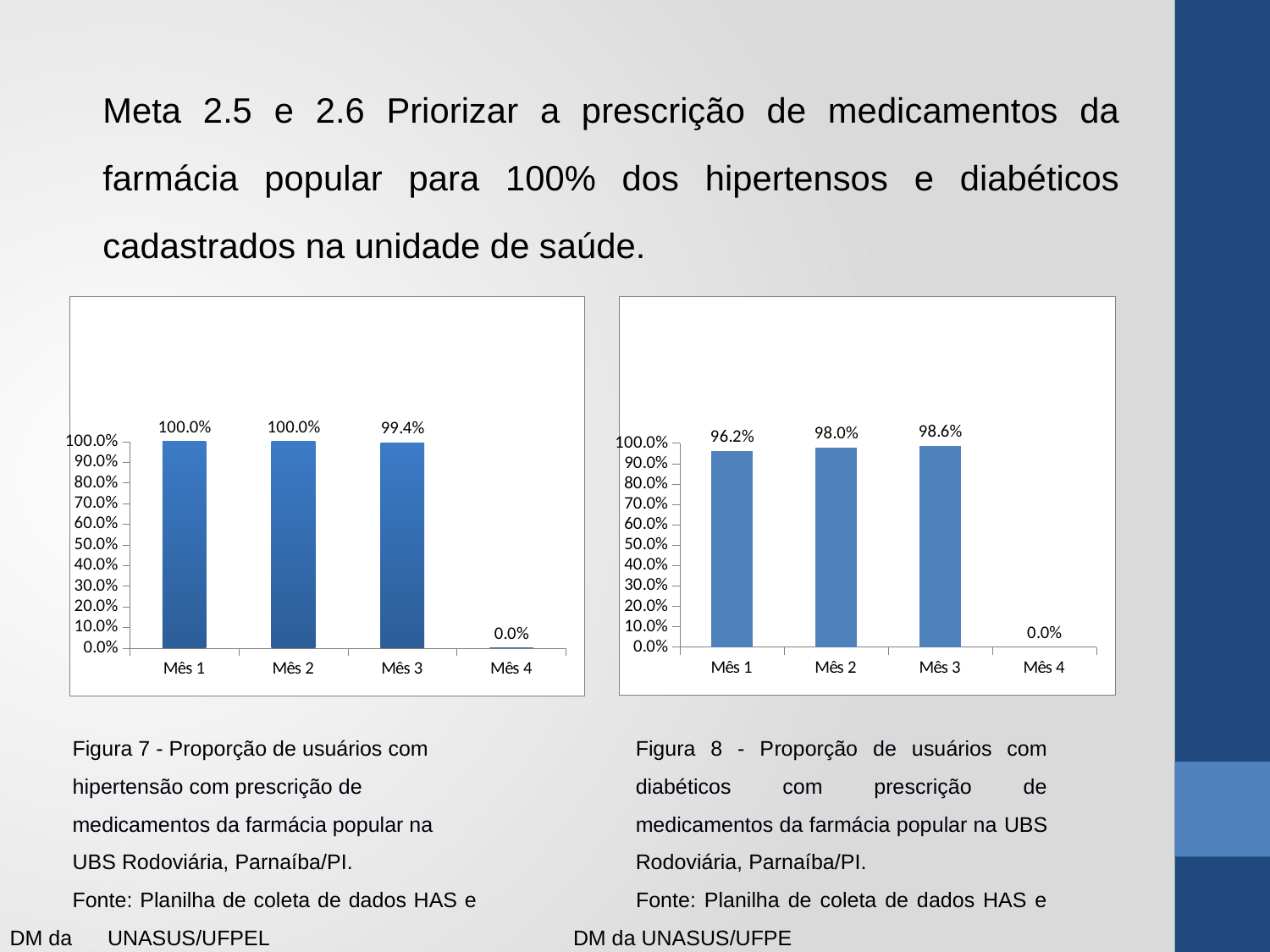
In the right chart (Figura 8), which month has the highest value? Mês 3 In the right chart (Figura 8), which is larger, the value for Mês 1 or the value for Mês 2? Mês 2 What kind of chart is the right chart (Figura 8)? Bar chart In the right chart (Figura 8), do the values rise or fall from Mês 1 to Mês 3? Rise In the left chart (Figura 7), what is the value for Mês 3? 99.4% In the right chart (Figura 8), what is the value for Mês 1? 96.2% In the right chart (Figura 8), what is the difference between the values for Mês 3 and Mês 1? 2.4% In the left chart (Figura 7), what is the difference between the values for Mês 2 and Mês 3? 0.6% How many months (categories) are shown in the left chart (Figura 7)? 4 In the right chart (Figura 8), what is the value for Mês 2? 98.0% In the right chart (Figura 8), is the value for Mês 1 greater or less than 90.0%? greater In the left chart (Figura 7), which month has the lowest value? Mês 4